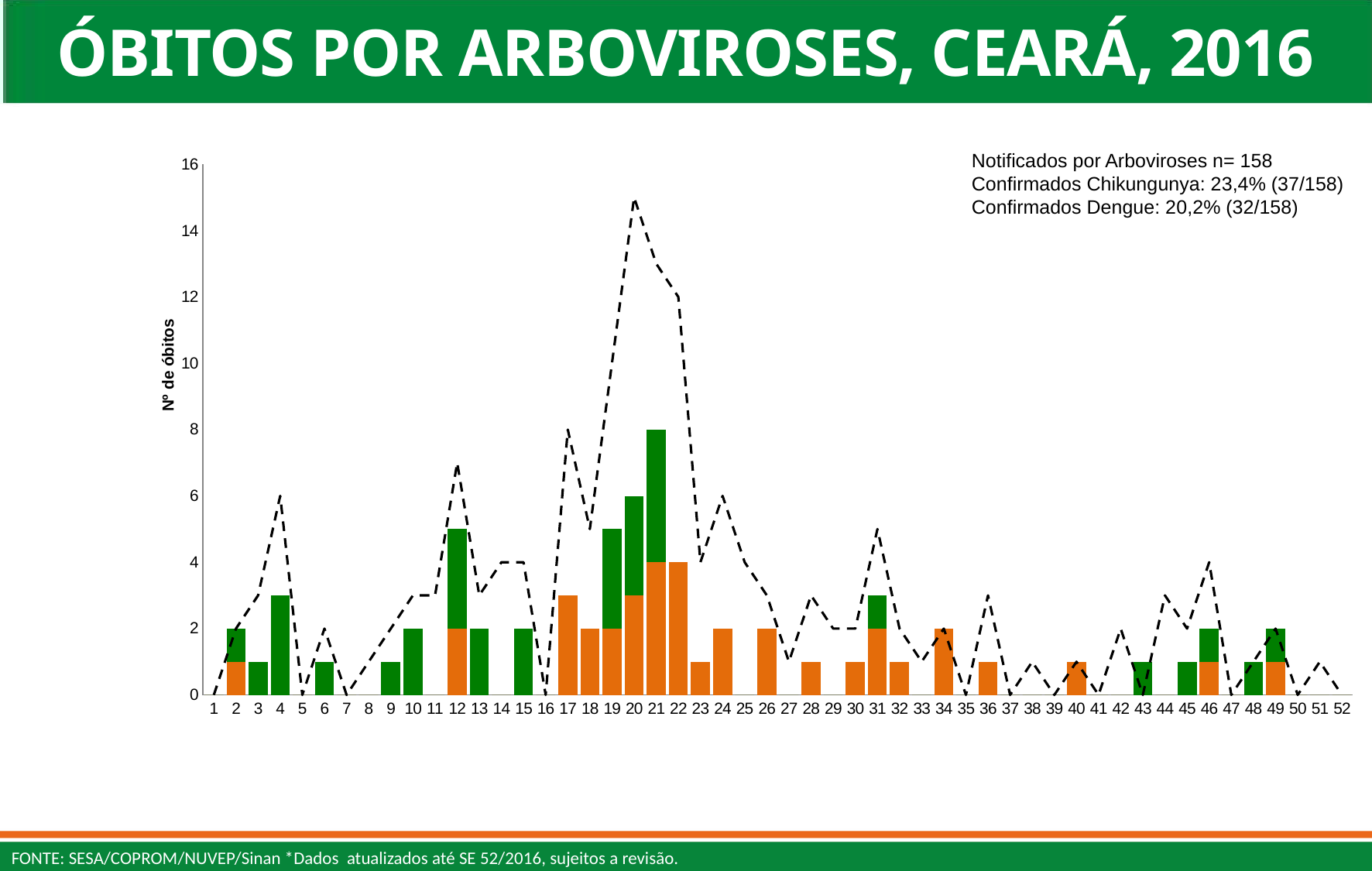
What is the value of the bar for week 22? 4 What is the total height of the stacked bar for week 21? 8 What is the title of the chart on the slide? ÓBITOS POR ARBOVIROSES, CEARÁ, 2016 Which is larger, the total bar for week 21 or the bar for week 22? week 21 Which week has the tallest stacked bar? 21 How many weeks (categories) are shown along the x axis? 52 What type of chart is shown on the slide? combination bar and line chart What is the difference between the total bar for week 21 and the bar for week 22? 4 Is the peak of the dashed line at week 20 greater or less than 14? greater Is the total bar for week 12 greater or less than 4? greater What is the label of the vertical axis? Nº de óbitos What is the total height of the stacked bar for week 20? 6